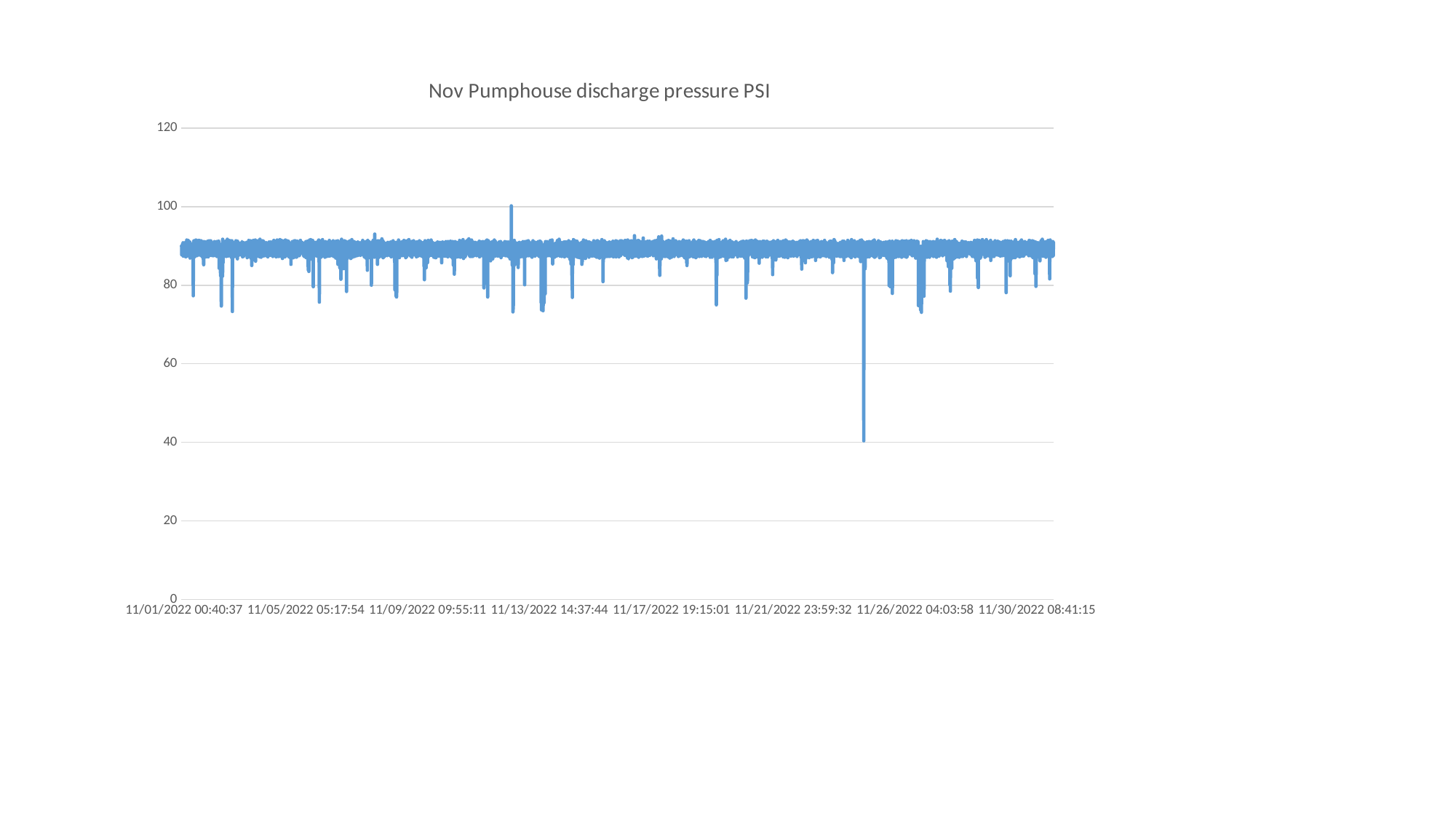
Is the lowest value plotted on the chart greater or less than 20? greater What is the highest tick value shown on the y axis? 120 Is the lowest value plotted on the chart greater or less than 60? less How many date labels are shown along the x axis? 8 Is the highest value plotted on the chart greater or less than 80? greater Do the plotted values generally rise, fall, or stay roughly flat across the month? Roughly flat What is the title of the chart? Nov Pumphouse discharge pressure PSI What kind of chart is shown on the slide? Line chart Is the deepest dip in the line closer to the 11/26/2022 04:03:58 label or the 11/05/2022 05:17:54 label? 11/26/2022 04:03:58